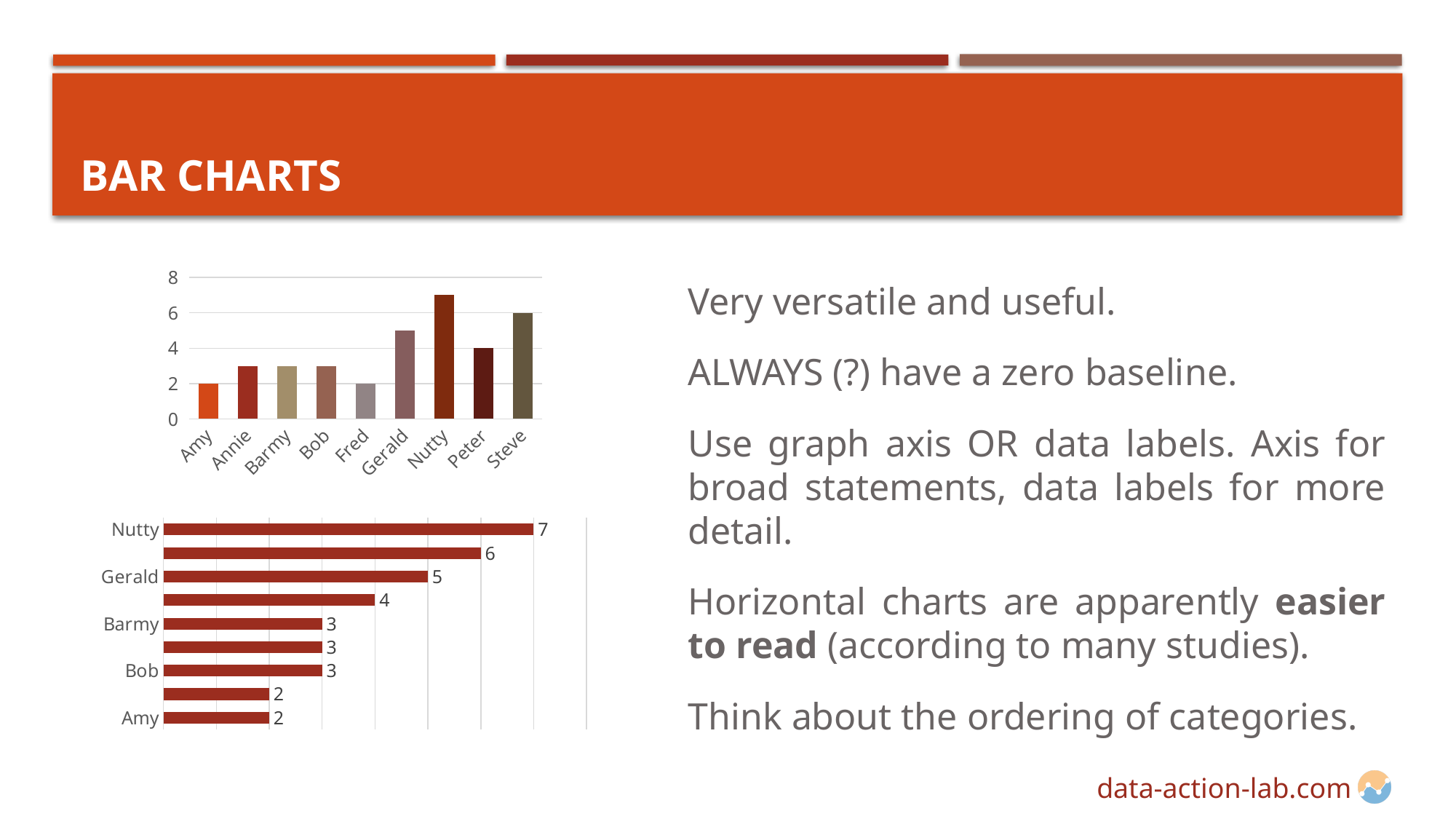
In the top chart, is the value for Gerald greater or less than 4? greater In the bottom chart, what is the difference between the values for Nutty and Amy? 5 In the bottom chart, what is the value for Gerald? 5 In the top chart, what is the value for Steve? 6 In the top chart, what is the value for Peter? 4 In the top chart, which category has the highest bar? Nutty In the top chart, is the value for Annie greater or less than 4? less In the top chart, which is larger, the value for Steve or the value for Peter? Steve In the top chart, how many categories are shown on the x axis? 9 In the bottom chart, what is the value for Nutty? 7 What kind of chart is the bottom chart? Bar chart